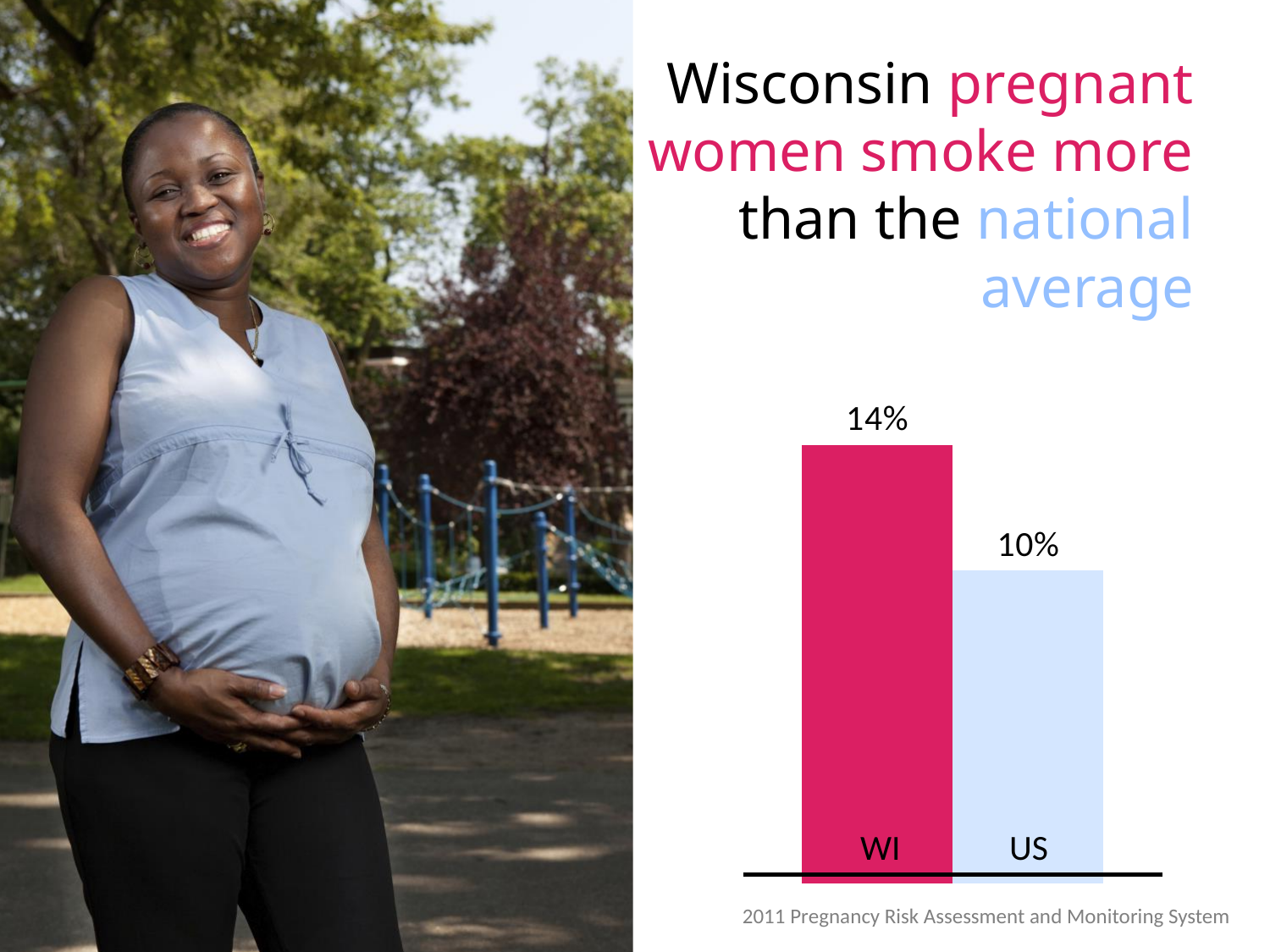
Which is larger, the value for WI or the value for US? WI Which category has the highest value? WI What is the difference between the WI and US values? 4% Which category has the lowest value? US What is the value for WI? 14% What source is cited below the chart? 2011 Pregnancy Risk Assessment and Monitoring System What colour is the WI bar? Pink What kind of chart is shown on the slide? Bar chart How many categories are shown in the chart? 2 What is the value for US? 10%